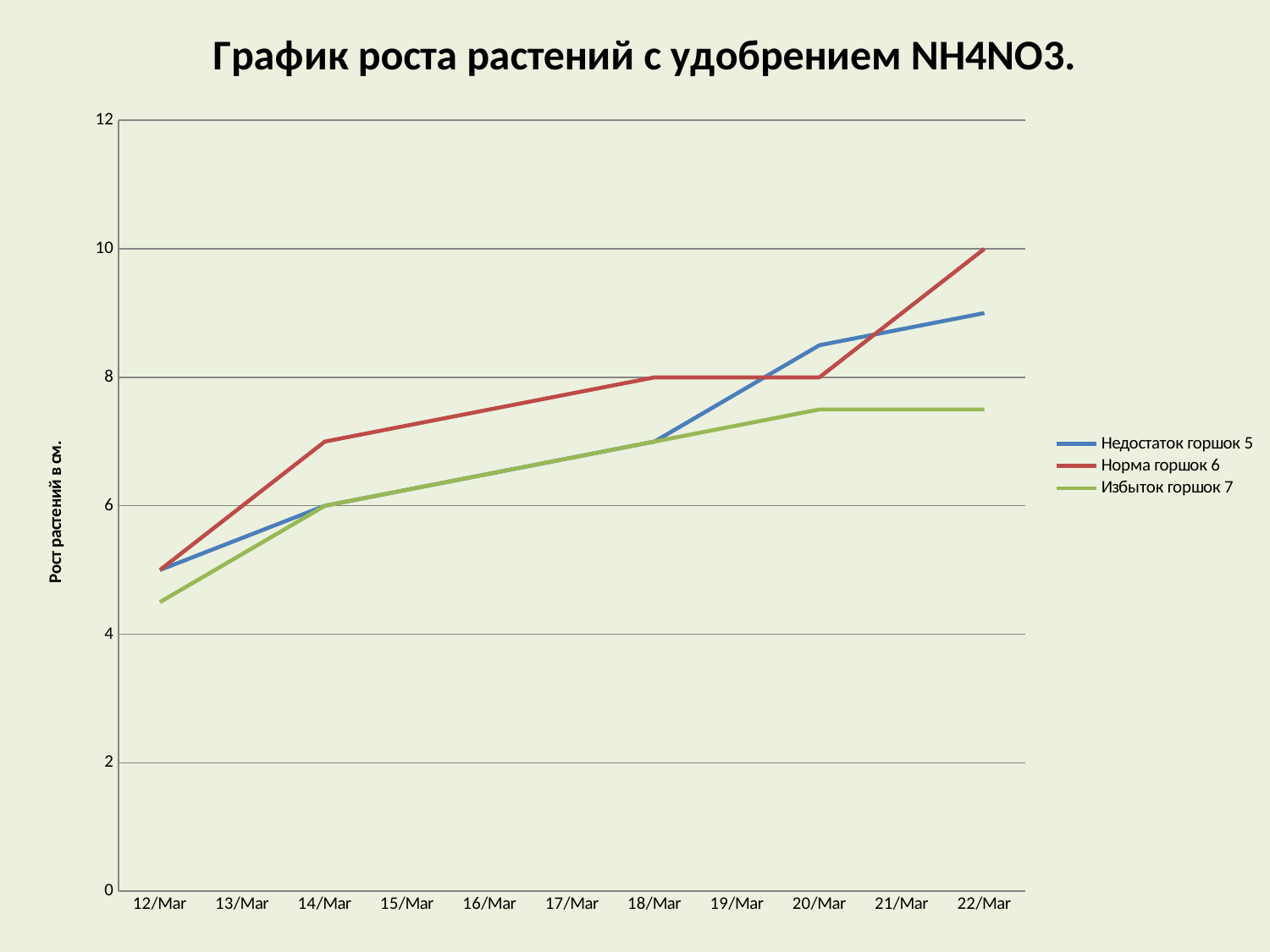
Is the value for Избыток горшок 7 on 22/Mar greater or less than 8? less Which series has the lowest value on 12/Mar? Избыток горшок 7 What kind of chart is shown on the slide? line chart How many series does the legend list? 3 How many dates are labelled on the x axis? 11 What is the value for Норма горшок 6 on 18/Mar? 8 Is the value for Недостаток горшок 5 on 22/Mar greater or less than 8? greater What is the value for Норма горшок 6 on 22/Mar? 10 Do the values for Норма горшок 6 generally rise or fall from 12/Mar to 22/Mar? rise On 22/Mar, which is larger: Норма горшок 6 or Избыток горшок 7? Норма горшок 6 Which series has the highest value on 22/Mar? Норма горшок 6 What is the value for Избыток горшок 7 on 14/Mar? 6